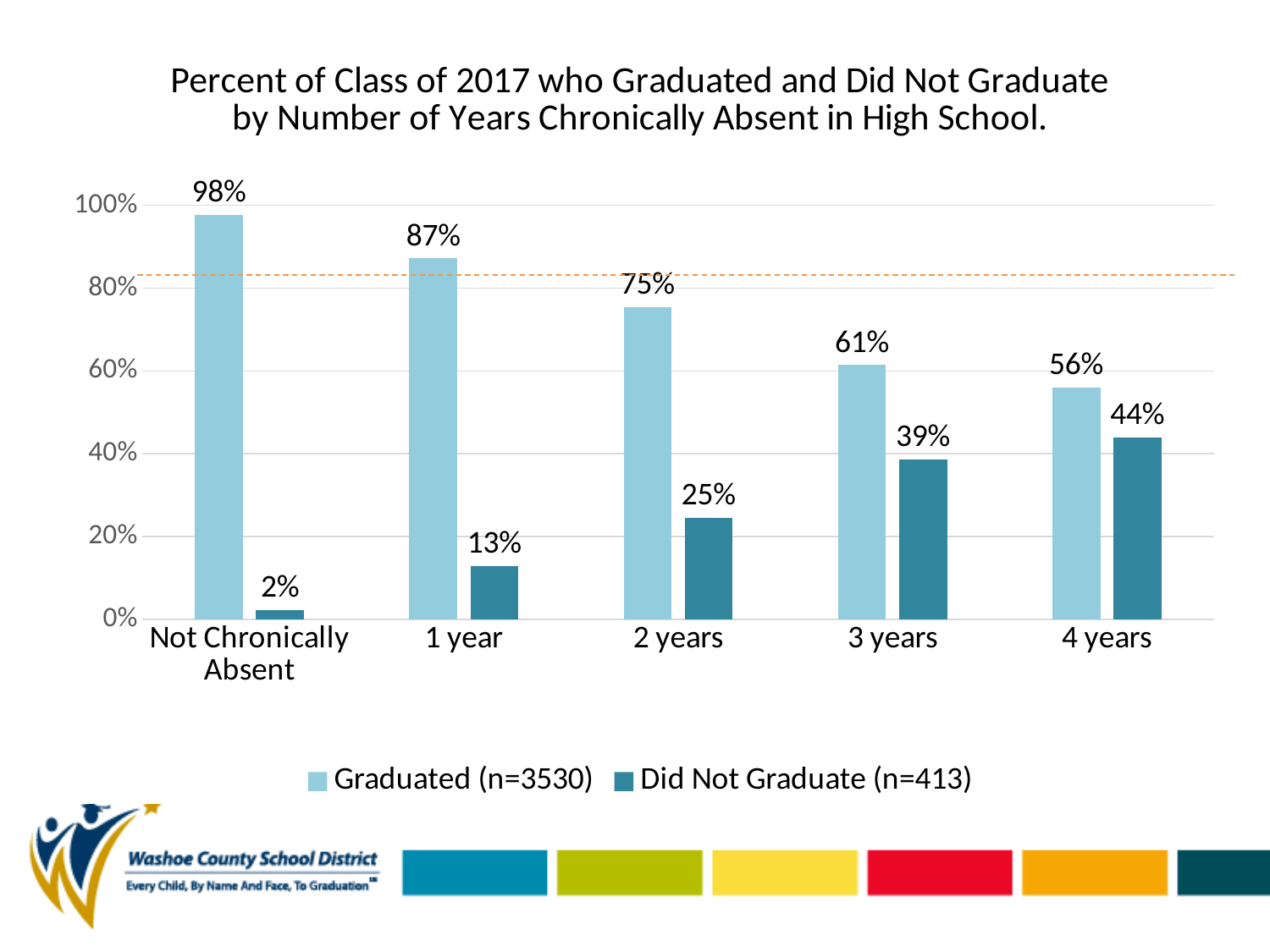
How many categories are shown on the x axis? 5 Which category has the highest Did Not Graduate percentage? 4 years Which category has the lowest Graduated percentage? 4 years What is the difference between the Graduated and Did Not Graduate percentages for 3 years? 22% What percent of the Class of 2017 who were not chronically absent graduated? 98% What is the Graduated value for students chronically absent 4 years? 56% Does the Graduated percentage rise or fall as the number of years chronically absent increases? fall Is the Did Not Graduate value for 1 year greater or less than 20%? less Which is larger: the Graduated value for 1 year or the Graduated value for 2 years? 1 year How many series does the legend list? 2 What is the Did Not Graduate value for students chronically absent 2 years? 25% What kind of chart is shown on the slide? bar chart